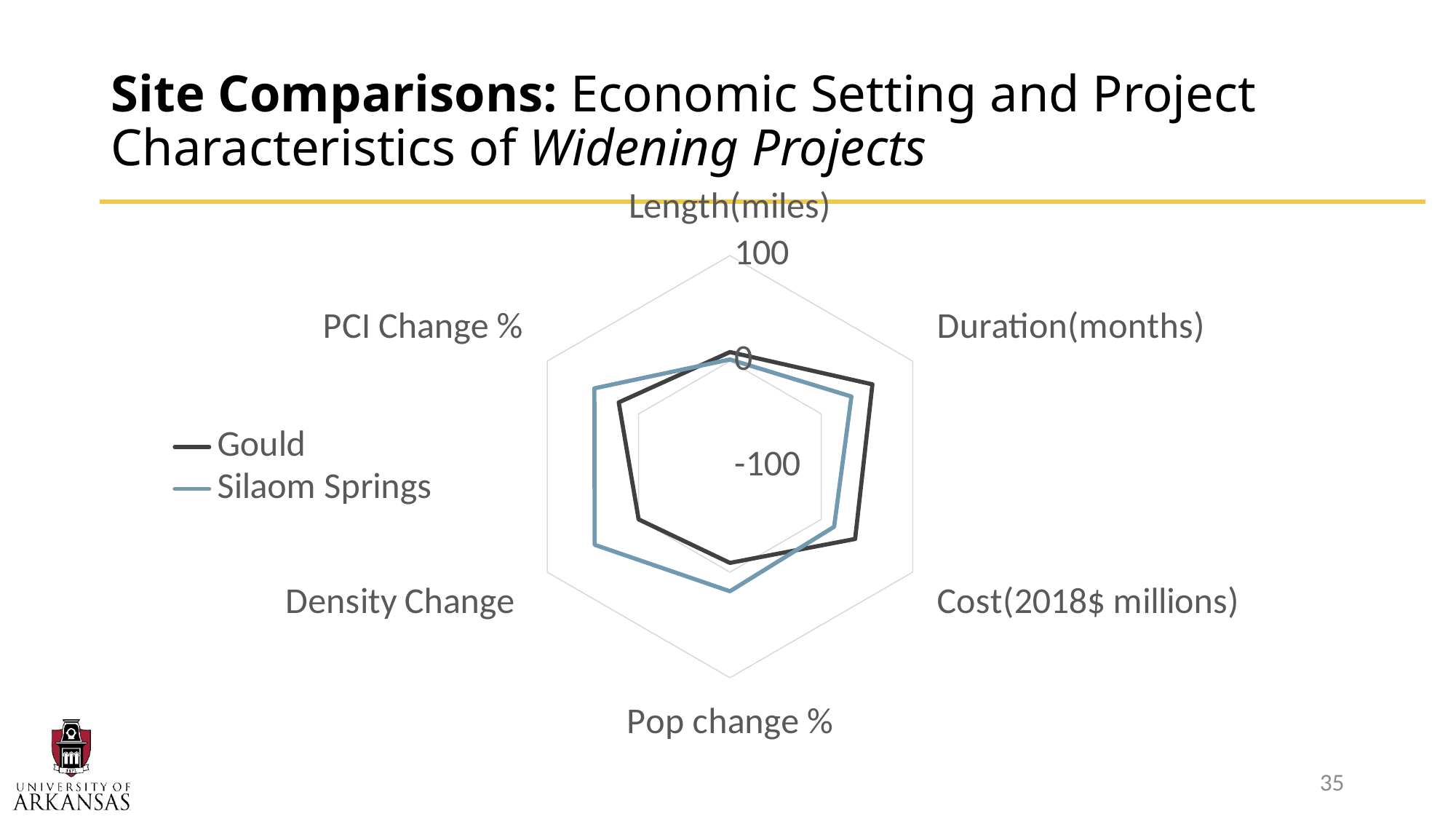
Which series has the larger value for Density Change, Gould or Silaom Springs? Silaom Springs Which series is drawn with the dark black line in the legend? Gould Which series has the larger value for Pop change %, Gould or Silaom Springs? Silaom Springs Is the Gould value for Duration(months) greater or less than 0? greater Which series has the larger value for Duration(months), Gould or Silaom Springs? Gould What kind of chart is shown on the slide? Radar chart Is the Silaom Springs value for Density Change greater or less than 0? greater Is the Gould value for Cost(2018$ millions) greater or less than 100? less How many axes (categories) does the radar chart have? 6 How many series does the legend list? 2 What is the highest value shown on the radar chart's axis scale? 100